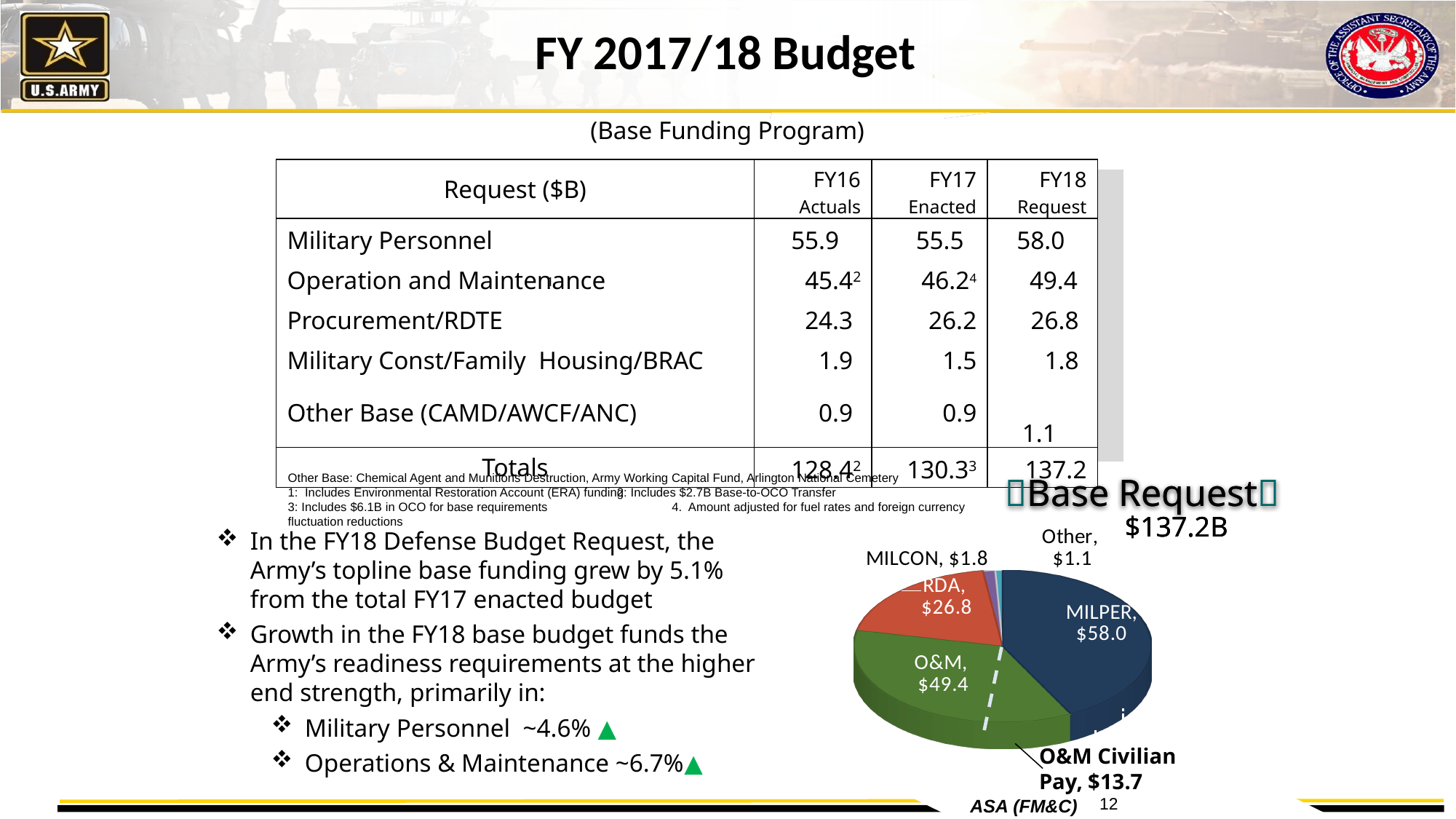
What total amount is shown in the title of the pie chart? $137.2B What kind of chart is shown on the slide? Pie chart What is the value shown for O&M in the pie chart? $49.4 What is the value shown for MILCON in the pie chart? $1.8 What value is shown for O&M Civilian Pay in the pie chart? $13.7 What is the difference between the MILCON and Other values in the pie chart? $0.7 Which is larger in the pie chart, RDA or O&M? O&M What is the difference between the MILPER and O&M values in the pie chart? $8.6 What is the value shown for MILPER in the pie chart? $58.0 Which slice of the pie chart is the smallest? Other What is the value shown for RDA in the pie chart? $26.8 Which slice of the pie chart is the largest? MILPER